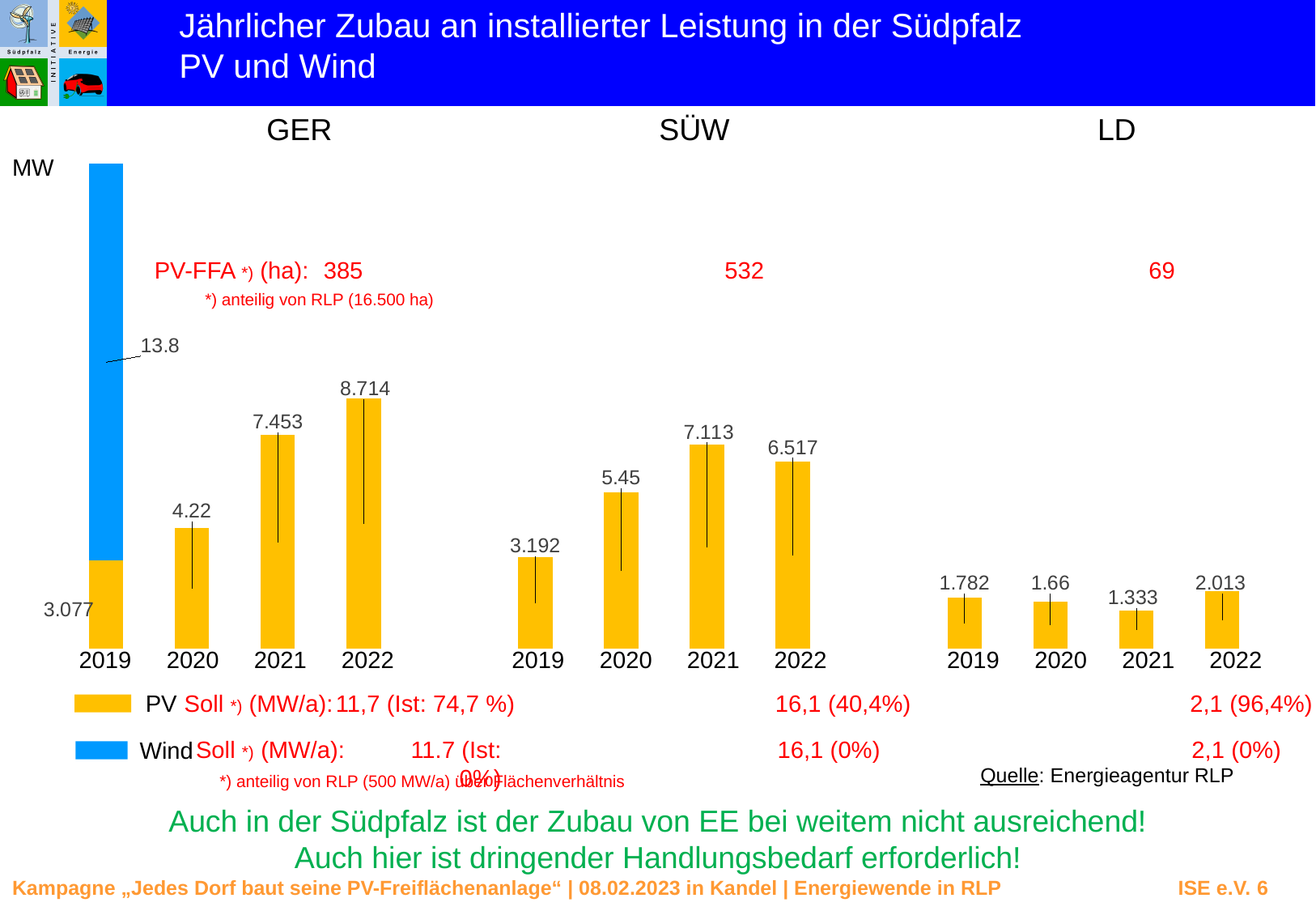
Do the PV values for GER rise or fall from 2019 to 2022? rise How many series does the legend list? 2 What is the PV value for SÜW in 2020? 5.45 Which is larger, the PV value for SÜW in 2022 or for GER in 2022? GER in 2022 Which year has the highest PV value in the SÜW group? 2021 What is the PV value for LD in 2021? 1.333 What is the Wind value shown for GER in 2019? 13.8 Which year has the lowest PV value in the LD group? 2021 What is the total of the stacked bar for GER in 2019 (PV plus Wind)? 16.877 What kind of chart is shown on the slide? bar chart What is the PV value for GER in 2022? 8.714 What is the difference between the PV values for GER in 2022 and 2021? 1.261